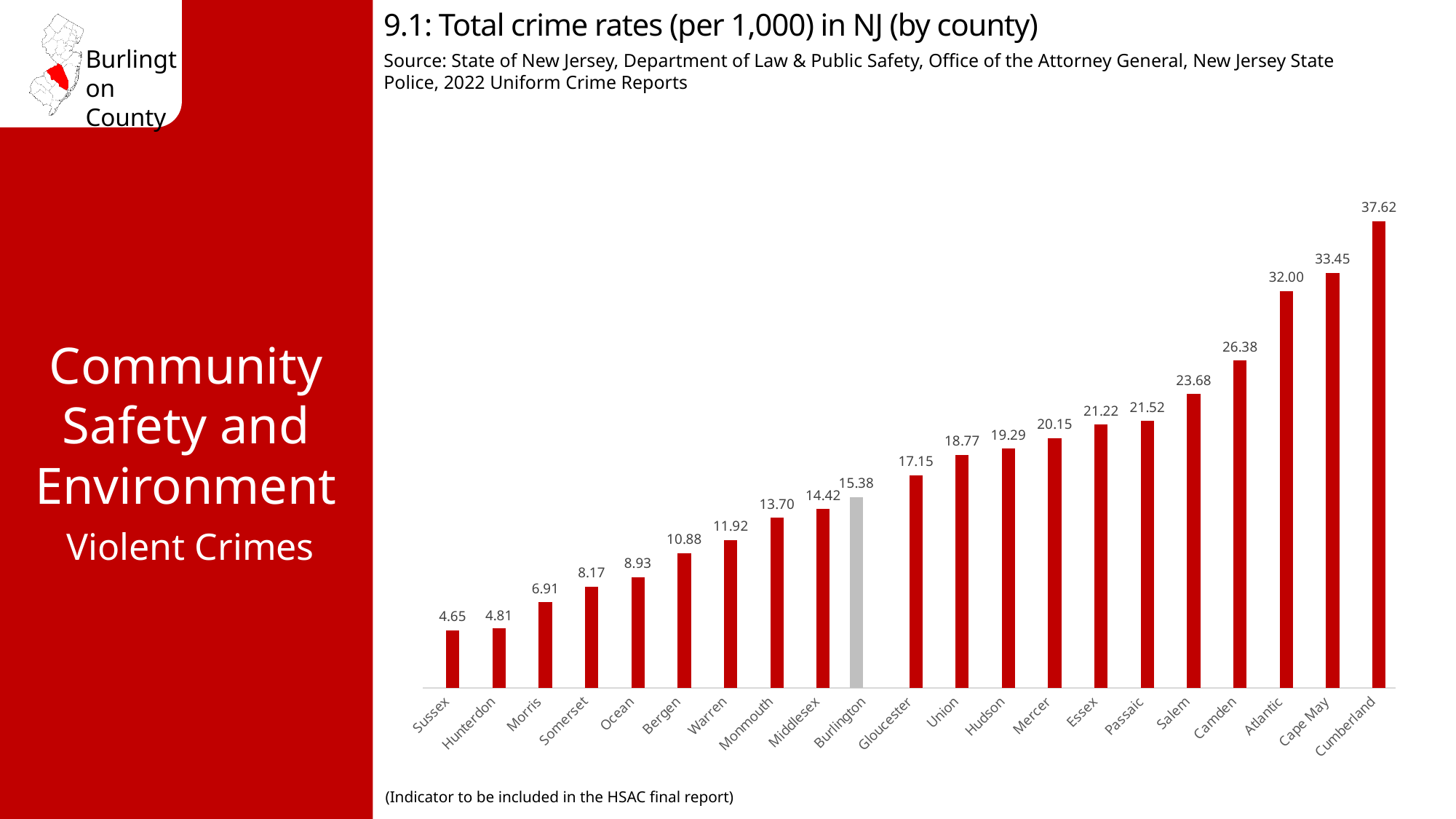
What is the total crime rate (per 1,000) for Cape May county? 33.45 Which county has a higher total crime rate, Camden or Salem? Camden What is the difference between the total crime rates of Cumberland and Sussex? 32.97 What is the total crime rate (per 1,000) for Burlington county? 15.38 Do the values rise or fall from left to right along the x axis? Rise What is the total crime rate (per 1,000) for Hudson county? 19.29 Which county has the highest total crime rate? Cumberland Which county's bar is coloured grey instead of red? Burlington How many counties are shown on the chart? 21 Which county has the lowest total crime rate? Sussex What kind of chart is shown on the slide? Bar chart What is the difference between the total crime rates of Burlington and Gloucester? 1.77